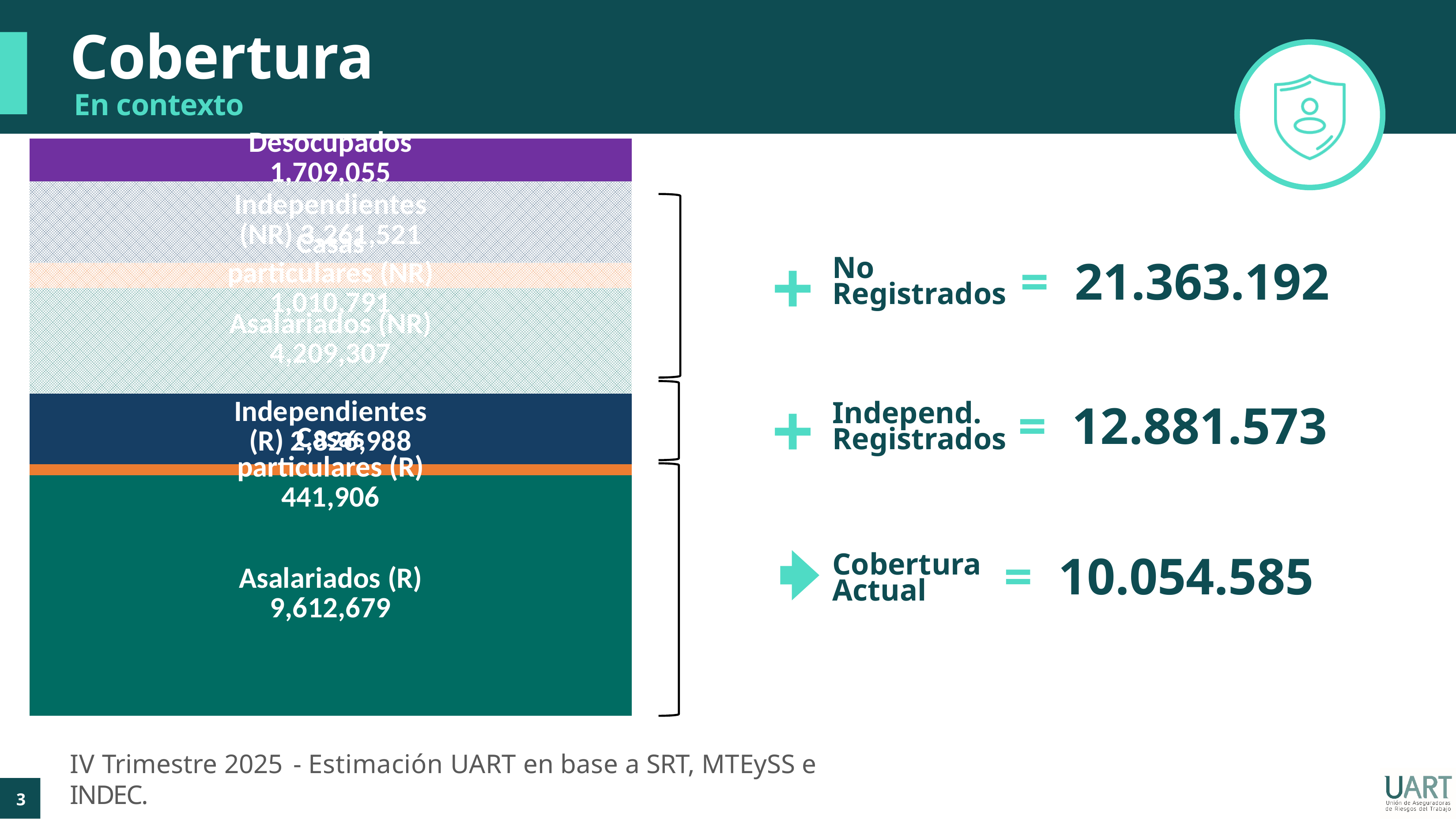
How many segments make up the stacked bar? 7 Which is larger, Asalariados (R) or Asalariados (NR)? Asalariados (R) What is the difference between Casas particulares (NR) and Casas particulares (R)? 568,885 What kind of chart is shown on the slide? Stacked bar chart What is the difference between Asalariados (R) and Asalariados (NR)? 5,403,372 Which segment of the stacked bar is the smallest? Casas particulares (R) What value is shown for the Casas particulares (NR) segment? 1,010,791 What value is shown for the Asalariados (R) segment of the stacked bar? 9,612,679 What value is shown for the Asalariados (NR) segment? 4,209,307 What value is shown for the Desocupados segment at the top of the bar? 1,709,055 Which segment of the stacked bar is the largest? Asalariados (R) What value is shown for the Casas particulares (R) segment? 441,906